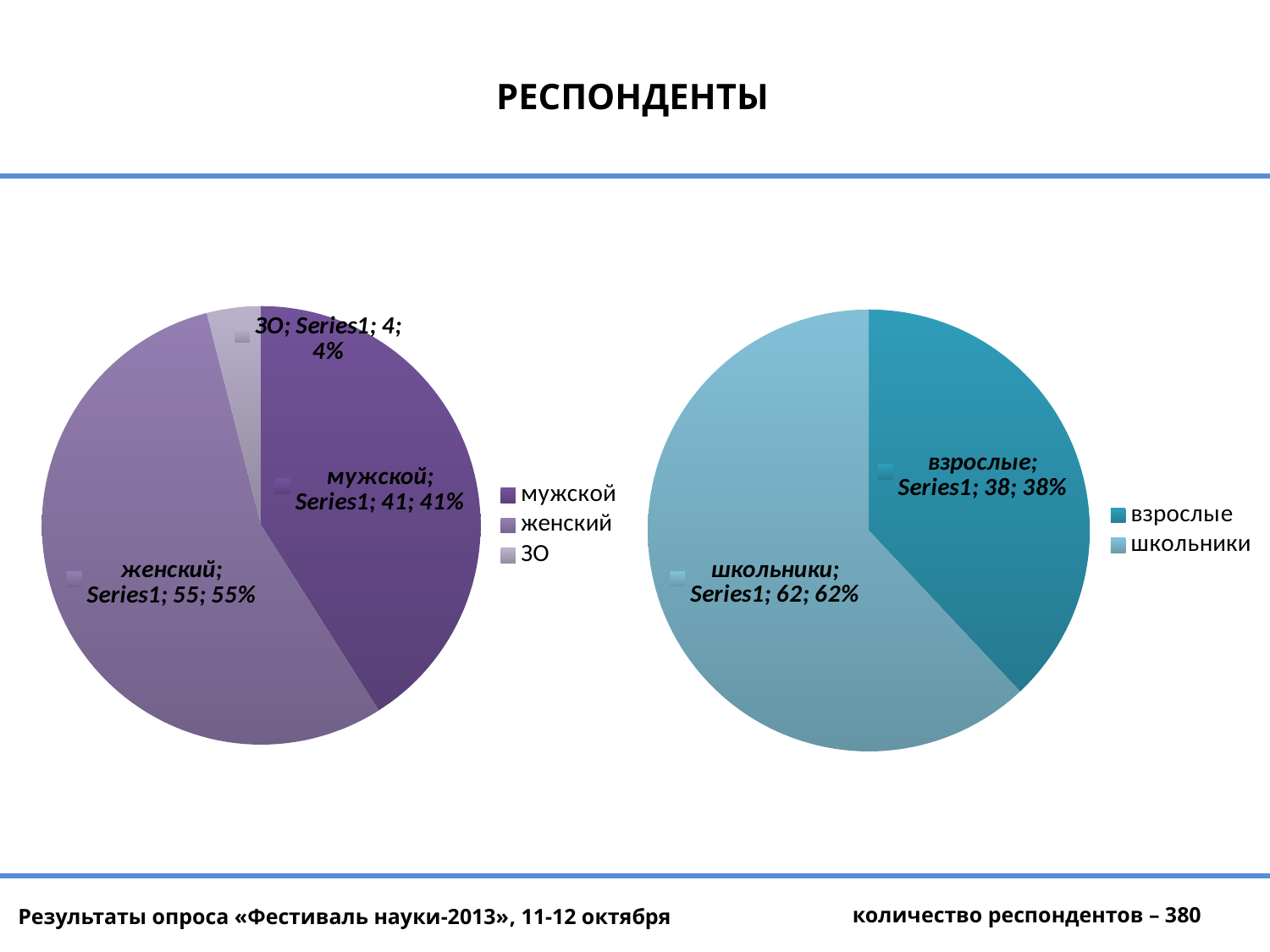
In the left pie chart, what is the value for ЗО? 4 How many categories does the left pie chart have? 3 In the left pie chart, what is the value for женский? 55 In the left pie chart, what is the difference between the values for женский and мужской? 14 In the left pie chart, which category has the smallest slice? ЗО In the left pie chart, which category has the largest slice? женский In the right pie chart, which is larger, взрослые or школьники? школьники In the left pie chart, what share of the pie does мужской take? 41% In the right pie chart, what share of the pie does взрослые take? 38% In the right pie chart, what is the value for школьники? 62 How many entries does the legend of the right pie chart list? 2 What kind of chart is the left chart on the slide? pie chart